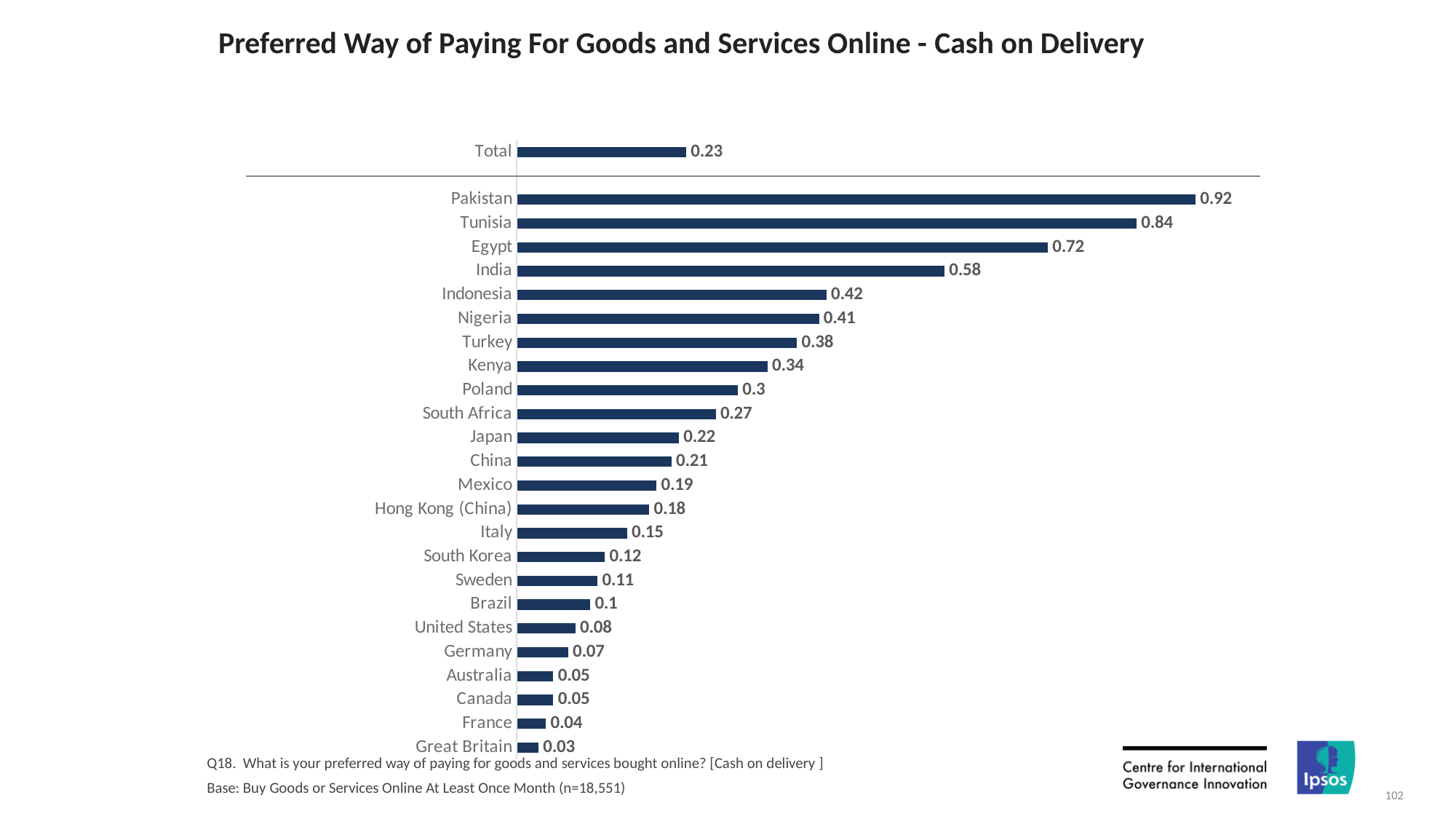
What is the value for Hong Kong (China)? 0.18 What is the title of the chart? Preferred Way of Paying For Goods and Services Online - Cash on Delivery What kind of chart is shown on the slide? Bar chart Which has a larger value, India or Indonesia? India Which has a larger value, Brazil or Sweden? Sweden What is the value for Total? 0.23 What is the difference between the values for Tunisia and Egypt? 0.12 Which country has the lowest value? Great Britain Do the country values rise or fall going down the chart from Pakistan to Great Britain? Fall What is the value for Pakistan? 0.92 How many countries are listed below the Total bar? 24 Which country has the highest value? Pakistan